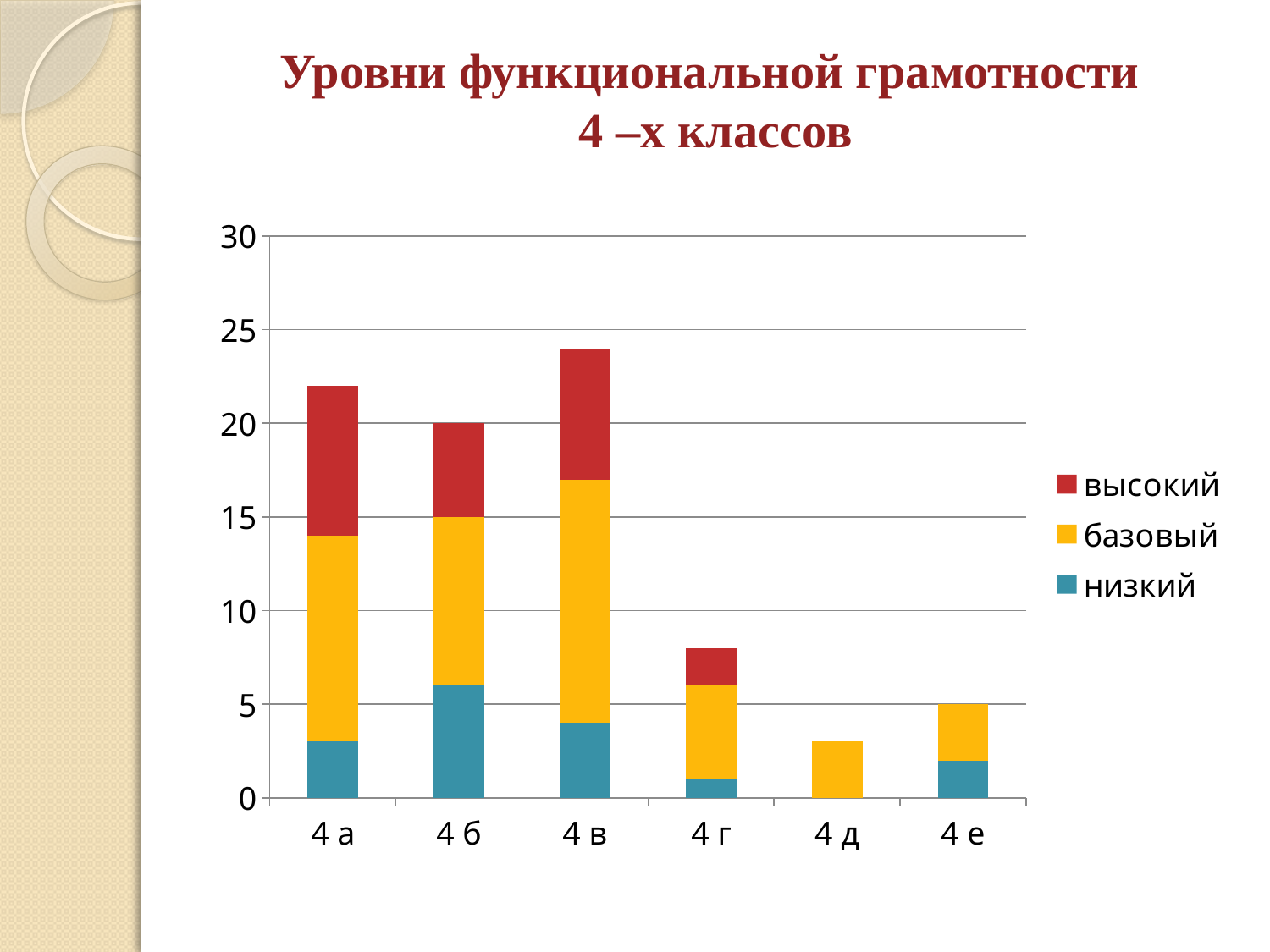
How many series does the legend list? 3 What is the total height of the stacked bar for 4 е? 5 How many classes (categories) are shown on the x axis? 6 Which class has the tallest stacked bar overall? 4 в Is the total for 4 г greater or less than 10? less Is the 'низкий' value for 4 а greater or less than 5? less What kind of chart is shown on the slide? Stacked bar chart What is the total height of the stacked bar for 4 б? 20 Which has the larger total bar, 4 г or 4 е? 4 г Which series is shown in red in the legend? высокий Is the total for 4 а greater or less than 20? greater Which class has the shortest stacked bar overall? 4 д